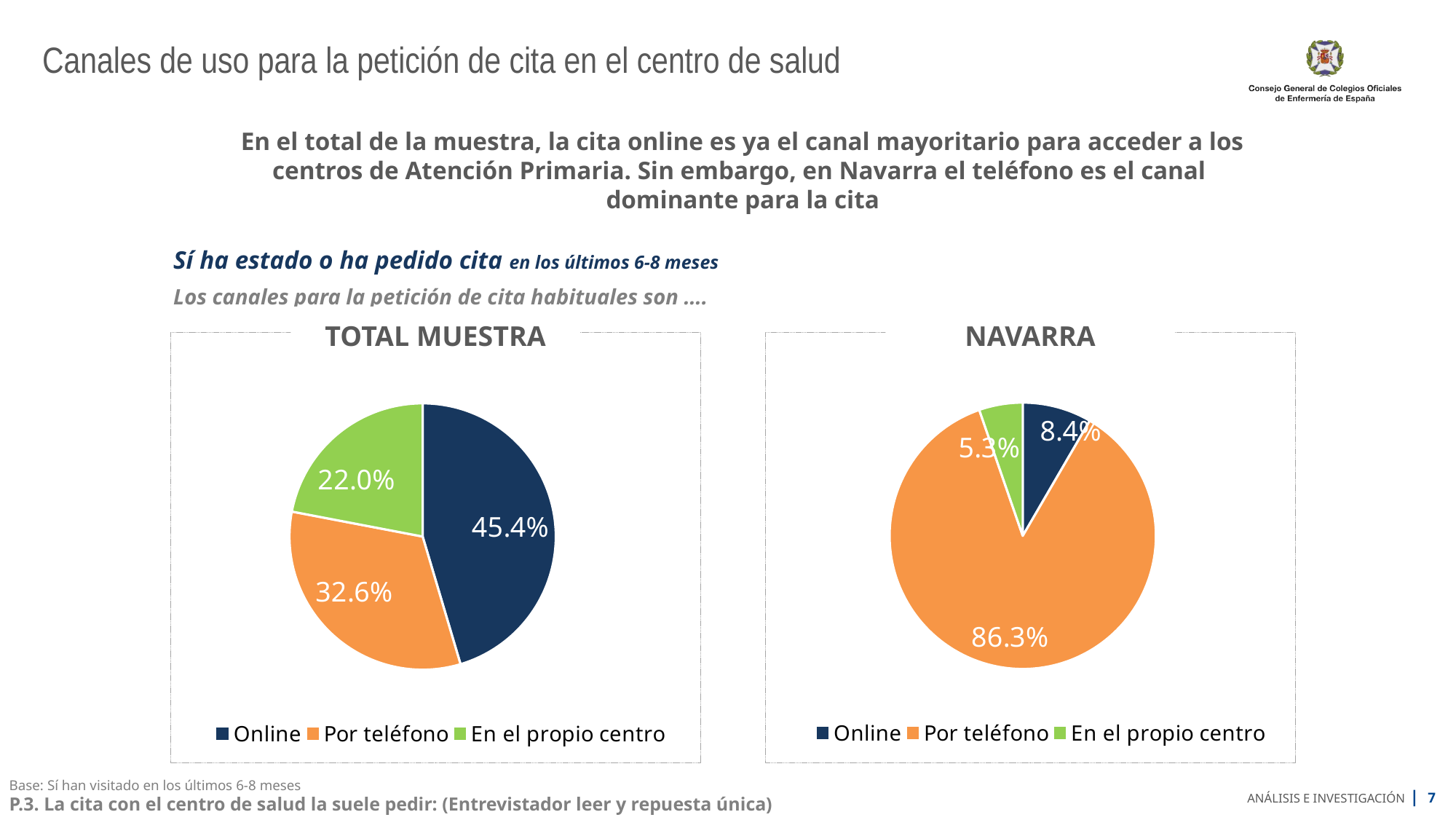
How many slices does the NAVARRA chart have? 3 In the NAVARRA chart, what is the value for Por teléfono? 86.3% What colour represents Por teléfono in the legend of the NAVARRA chart? Orange In the NAVARRA chart, what is the value for En el propio centro? 5.3% In the TOTAL MUESTRA chart, what is the value for Online? 45.4% In the TOTAL MUESTRA chart, which category has the largest share? Online Which is larger in the TOTAL MUESTRA chart: Por teléfono or En el propio centro? Por teléfono In the TOTAL MUESTRA chart, what is the value for Por teléfono? 32.6% In the NAVARRA chart, what is the difference between Por teléfono and Online? 77.9% In the TOTAL MUESTRA chart, what is the difference between Online and Por teléfono? 12.8% What type of chart is the TOTAL MUESTRA chart? Pie chart In the NAVARRA chart, which category has the smallest share? En el propio centro